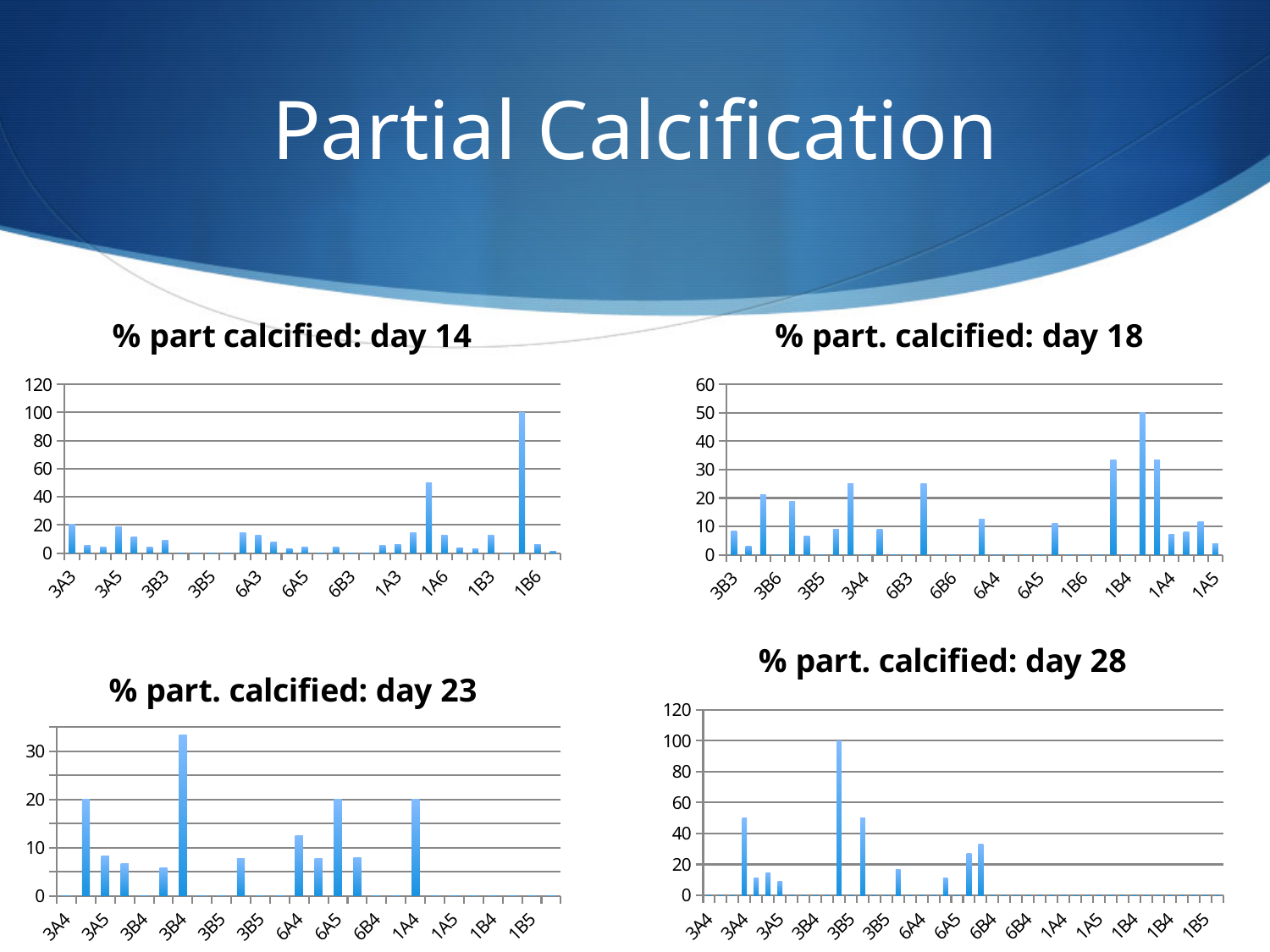
In the '% part. calcified: day 28' chart, what value does the tallest bar reach? 100 How many charts are shown on the slide? 4 In the '% part. calcified: day 18' chart, is the tallest bar greater or less than 40? greater Which chart has the taller maximum bar: '% part calcified: day 14' or '% part. calcified: day 18'? % part calcified: day 14 In the '% part. calcified: day 23' chart, is the tallest bar greater or less than 30? greater In the '% part calcified: day 14' chart, what value does the tallest bar reach? 100 In the '% part. calcified: day 18' chart, what value does the tallest bar reach? 50 What is the title of the top-left chart? % part calcified: day 14 What is the highest value shown on the y-axis of the '% part calcified: day 14' chart? 120 What type of chart is used for the '% part calcified: day 14' chart? bar chart In the '% part. calcified: day 23' chart, how many bars reach exactly 20? 3 In the '% part calcified: day 14' chart, is the second-tallest bar greater or less than 40? greater